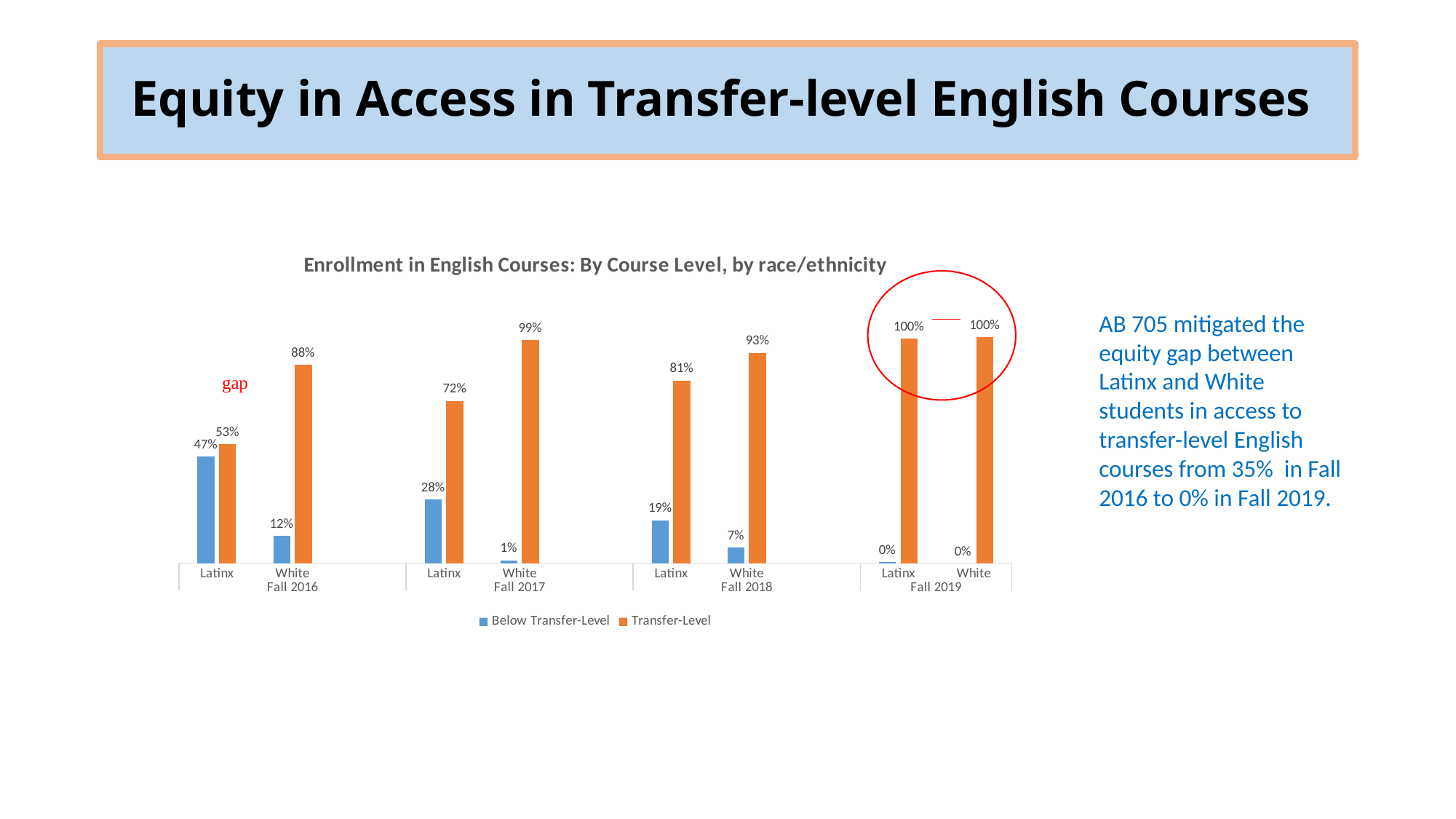
How many series does the legend list? 2 What is the Below Transfer-Level value for Latinx students in Fall 2018? 19% Which group and term has the highest Below Transfer-Level value? Latinx, Fall 2016 What is the difference between the Transfer-Level values for White and Latinx students in Fall 2017? 27% Does the Transfer-Level value for Latinx students rise or fall from Fall 2016 to Fall 2019? Rise What is the difference between the Transfer-Level values for White and Latinx students in Fall 2016? 35% What is the title of the chart? Enrollment in English Courses: By Course Level, by race/ethnicity What is the Transfer-Level value for Latinx students in Fall 2016? 53% What kind of chart is shown on the slide? Bar chart What is the Below Transfer-Level value for White students in Fall 2017? 1% What is the Transfer-Level value for White students in Fall 2018? 93% Which is larger: the Transfer-Level value for Latinx students in Fall 2018 or for Latinx students in Fall 2017? Latinx, Fall 2018